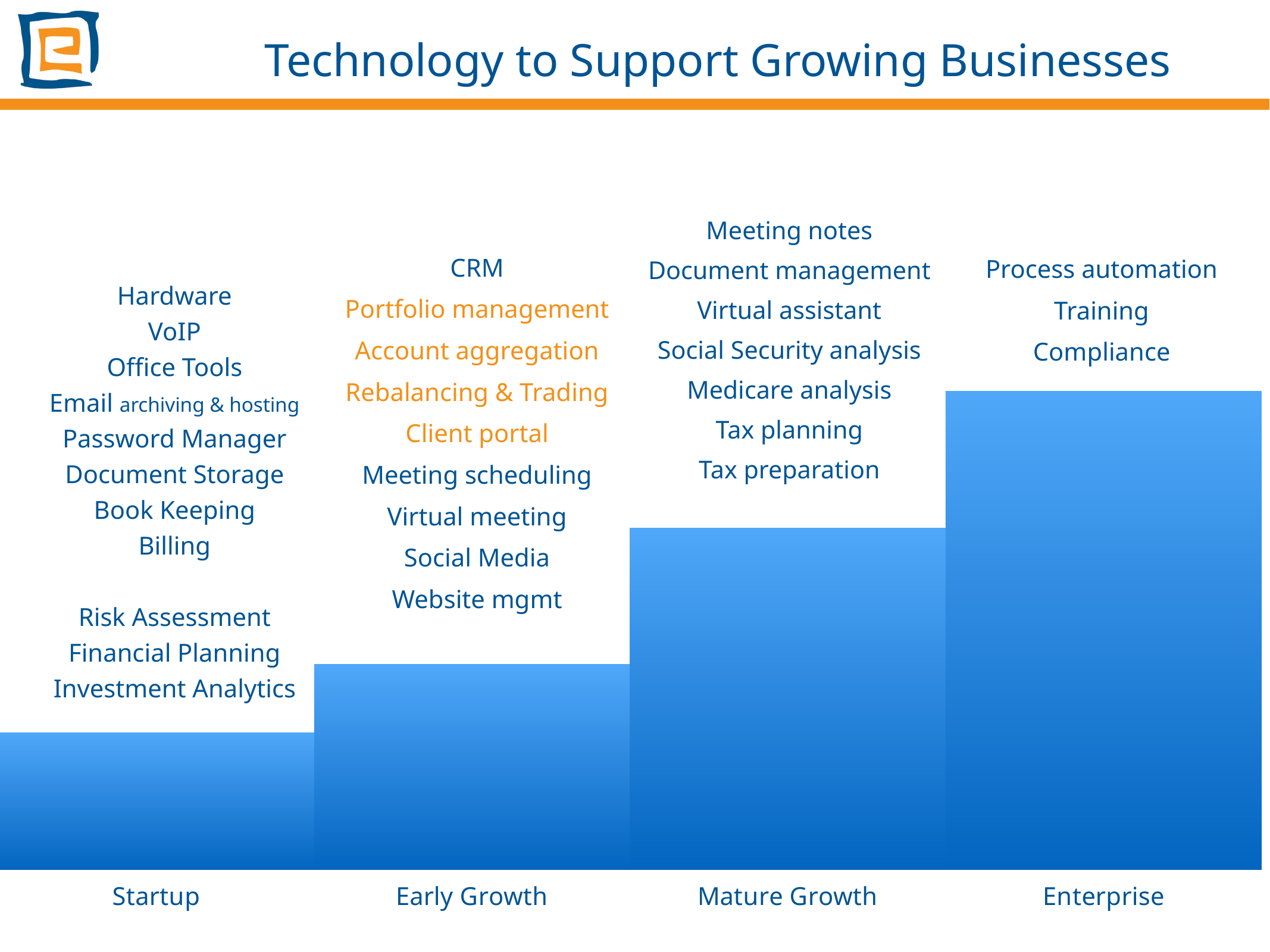
What is the title of the slide containing the chart? Technology to Support Growing Businesses What kind of chart is shown on the slide? bar chart What is the label of the third category from the left on the x axis? Mature Growth How many categories are shown along the x axis of the chart? 4 Which bar is taller, Early Growth or Mature Growth? Mature Growth Do the bars rise or fall from left to right across the x axis? rise Which bar is taller, Startup or Early Growth? Early Growth Which bar is taller, Mature Growth or Enterprise? Enterprise Which category has the shortest bar? Startup Which category has the tallest bar? Enterprise